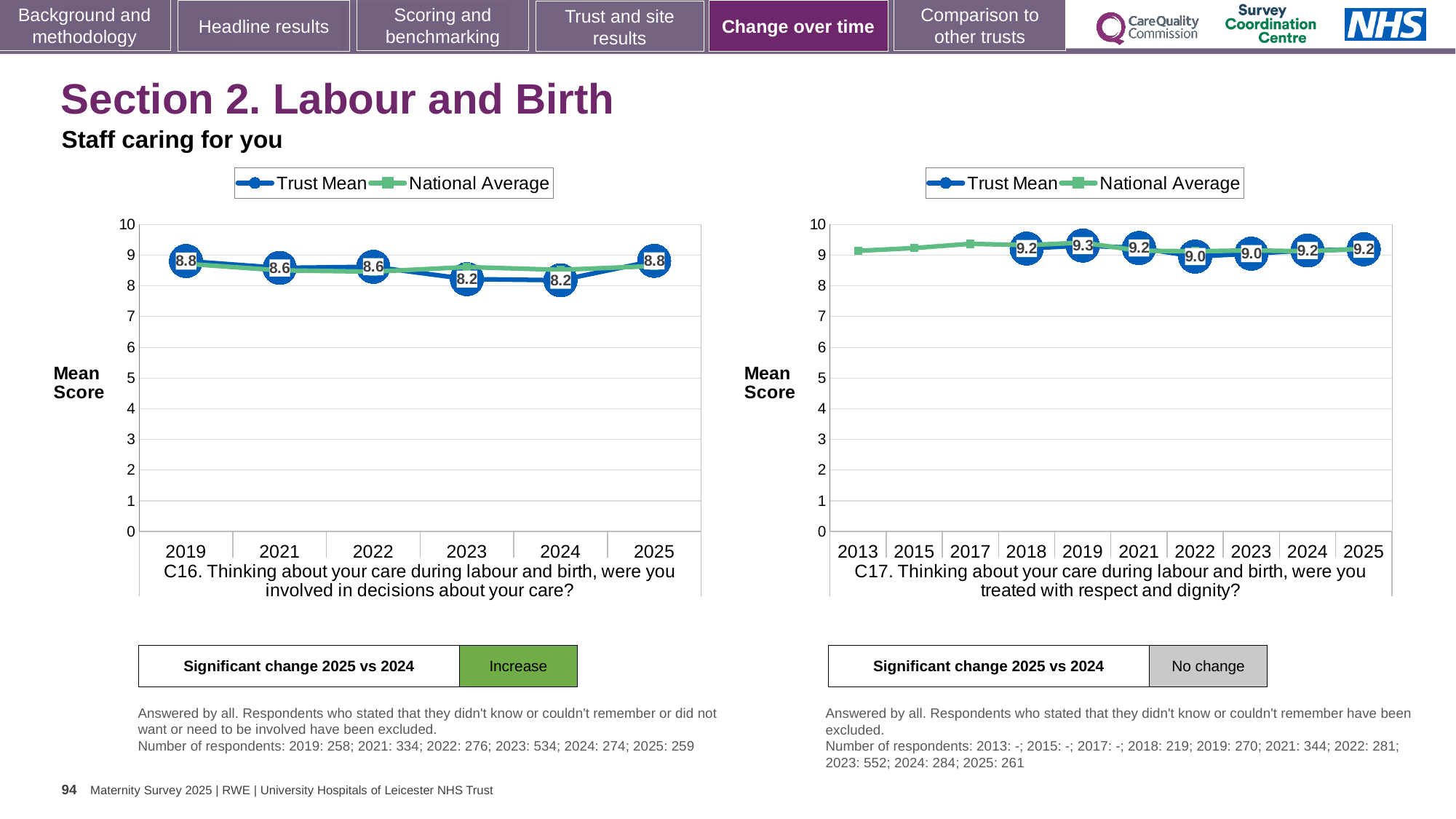
What type of chart is the left chart (C16)? Line chart On the left chart (C16), by how much did the Trust Mean change from 2024 to 2025? 0.6 On the right chart (C17), how many series does the legend list? 2 On the right chart (C17), in which year is the Trust Mean score highest? 2019 On the left chart (C16), what is the Trust Mean score for 2023? 8.2 On the right chart (C17), what is the Trust Mean score for 2019? 9.3 On the left chart (C16), how many years are shown on the x axis? 6 On the left chart (C16), which year has the larger Trust Mean score, 2019 or 2023? 2019 On the right chart (C17), how many years are shown on the x axis? 10 On the right chart (C17), what is the Trust Mean score for 2022? 9.0 On the right chart (C17), what is the difference between the Trust Mean scores for 2019 and 2022? 0.3 On the left chart (C16), what is the Trust Mean score for 2025? 8.8